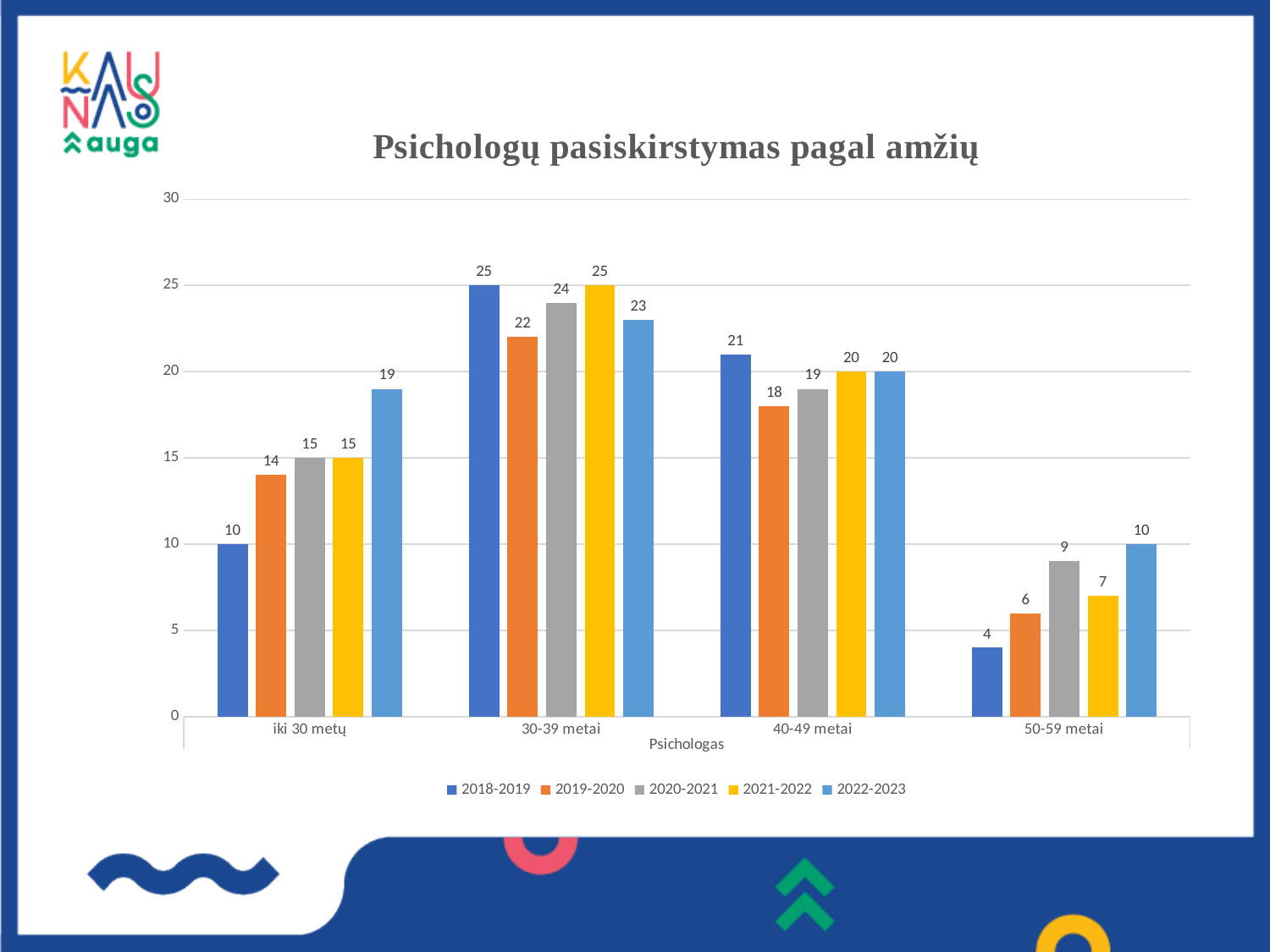
What kind of chart is shown on the slide? Bar chart Which is larger in the '40-49 metai' category: the value for 2018-2019 or for 2019-2020? 2018-2019 How many age categories are shown on the x axis? 4 Which age category has the highest value for 2018-2019? 30-39 metai What is the difference between the 2022-2023 and 2018-2019 values in the 'iki 30 metų' category? 9 How many series does the legend list? 5 What is the value for 2018-2019 in the '50-59 metai' category? 4 Which age category has the lowest value for 2021-2022? 50-59 metai What is the value for 2022-2023 in the 'iki 30 metų' category? 19 What is the value for 2019-2020 in the '30-39 metai' category? 22 Do the values for 2022-2023 rise or fall from '40-49 metai' to '50-59 metai'? Fall What is the title of the chart? Psichologų pasiskirstymas pagal amžių